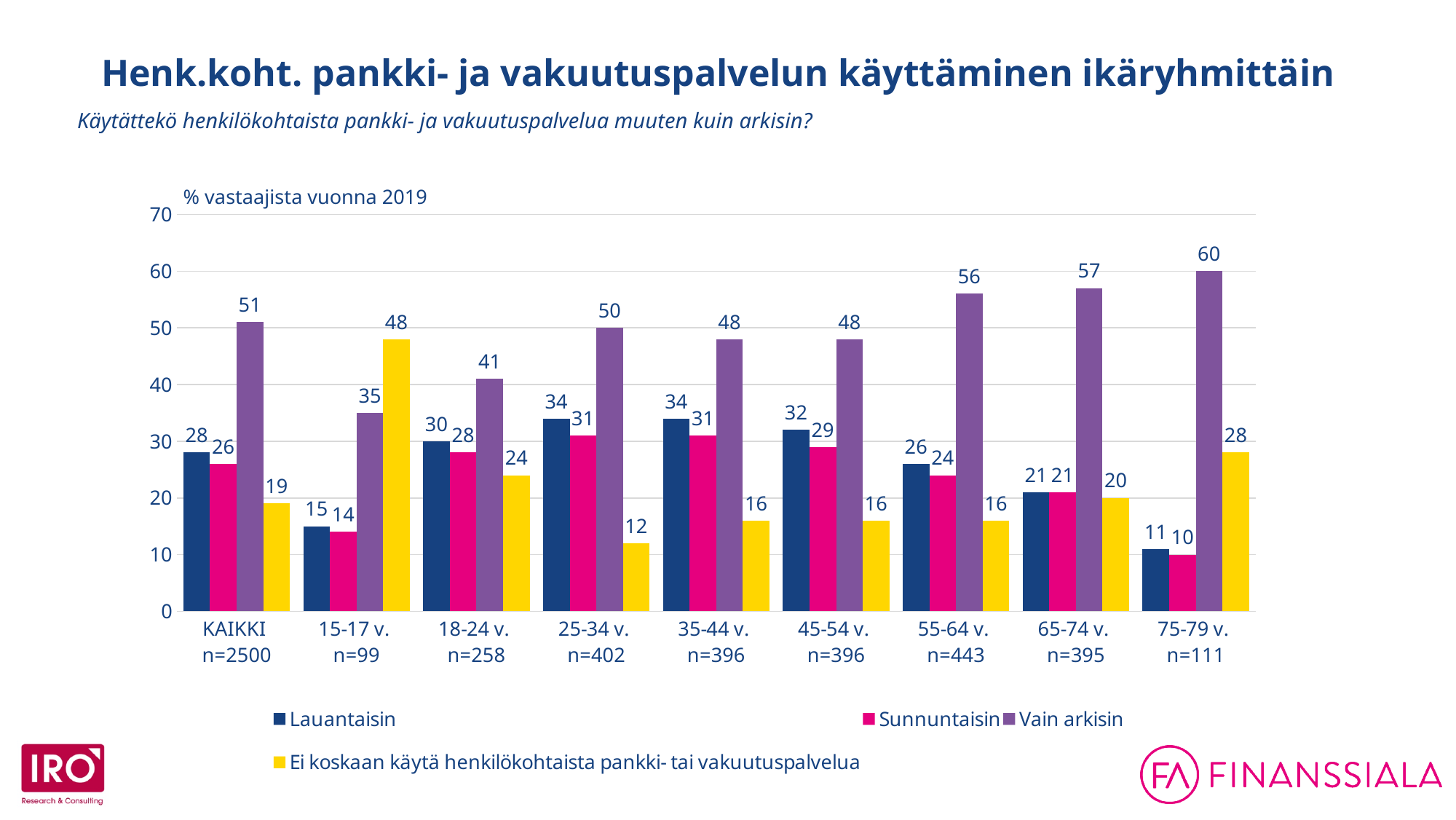
Which age group has the lowest value for 'Sunnuntaisin'? 75-79 v. Which is larger in the 18-24 v. group: 'Lauantaisin' or 'Sunnuntaisin'? Lauantaisin How many series does the legend list? 4 What is the value for 'Ei koskaan käytä henkilökohtaista pankki- tai vakuutuspalvelua' in the 15-17 v. group? 48 What is the difference between the 'Vain arkisin' value and the 'Lauantaisin' value in the 65-74 v. group? 36 What is the value for 'Lauantaisin' in the KAIKKI group? 28 What is the value for 'Sunnuntaisin' in the 45-54 v. group? 29 How many age groups (including KAIKKI) are shown on the x axis? 9 What is the value for 'Vain arkisin' in the 75-79 v. group? 60 What kind of chart is shown on the slide? Bar chart Which age group has the highest value for 'Vain arkisin'? 75-79 v. What is the sample size (n) shown for the 55-64 v. group? n=443